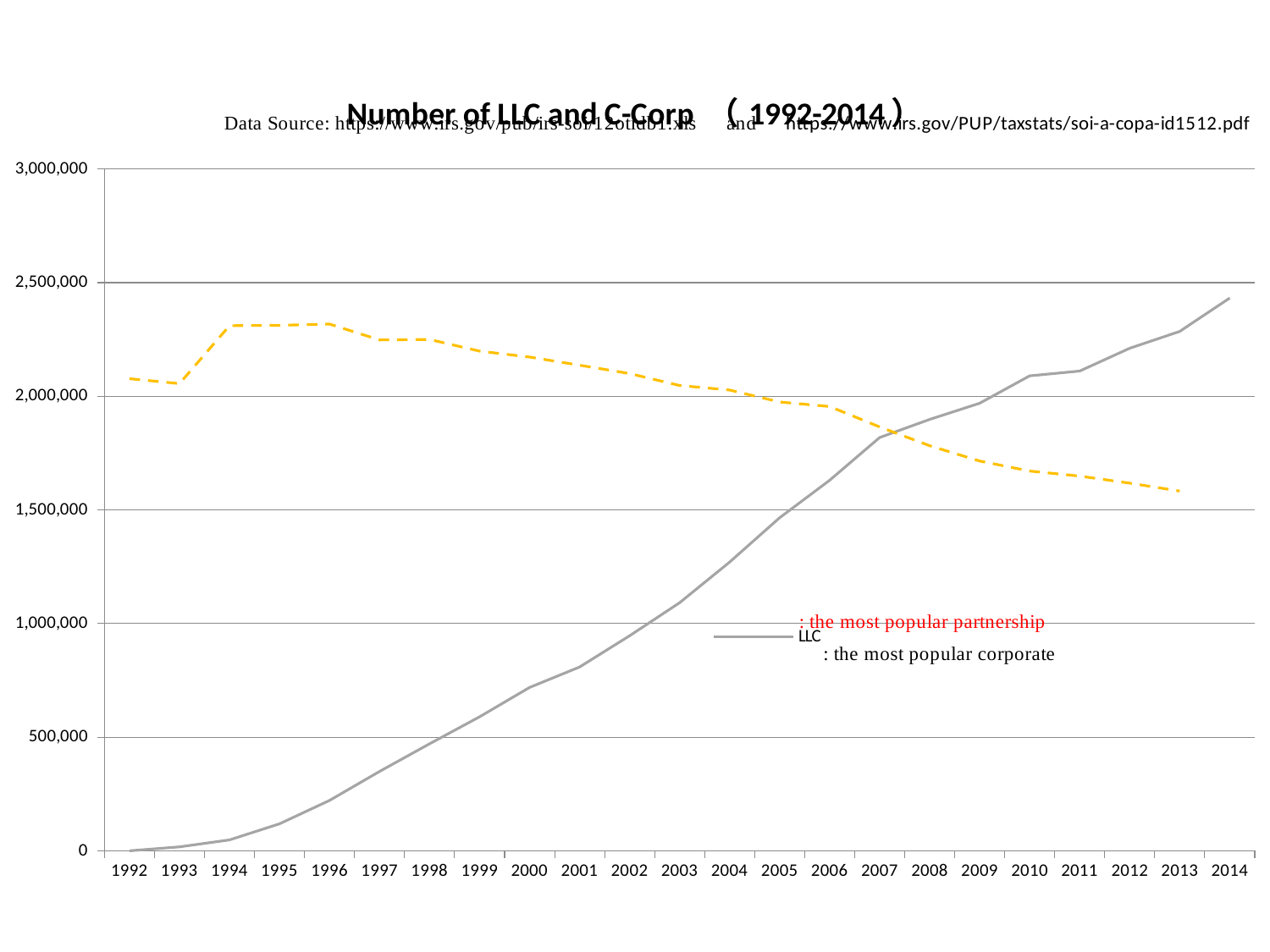
What is the title of the chart? Number of LLC and C-Corp (1992-2014) Does the LLC line rise or fall from 1992 to 2014? Rises Is the value of the dashed yellow line in 2013 greater or less than 2,000,000? less Is the value of the dashed yellow line in 1996 greater or less than 2,000,000? greater Is the value of the LLC line in 2014 greater or less than 2,000,000? greater How many years are labelled along the x axis of the chart? 23 In 2000, which line has the higher value, the LLC line or the dashed yellow line? The dashed yellow line How many lines are plotted on the chart? 2 What kind of chart is shown on the slide? Line chart In 2010, which line has the higher value, the LLC line or the dashed yellow line? The LLC line